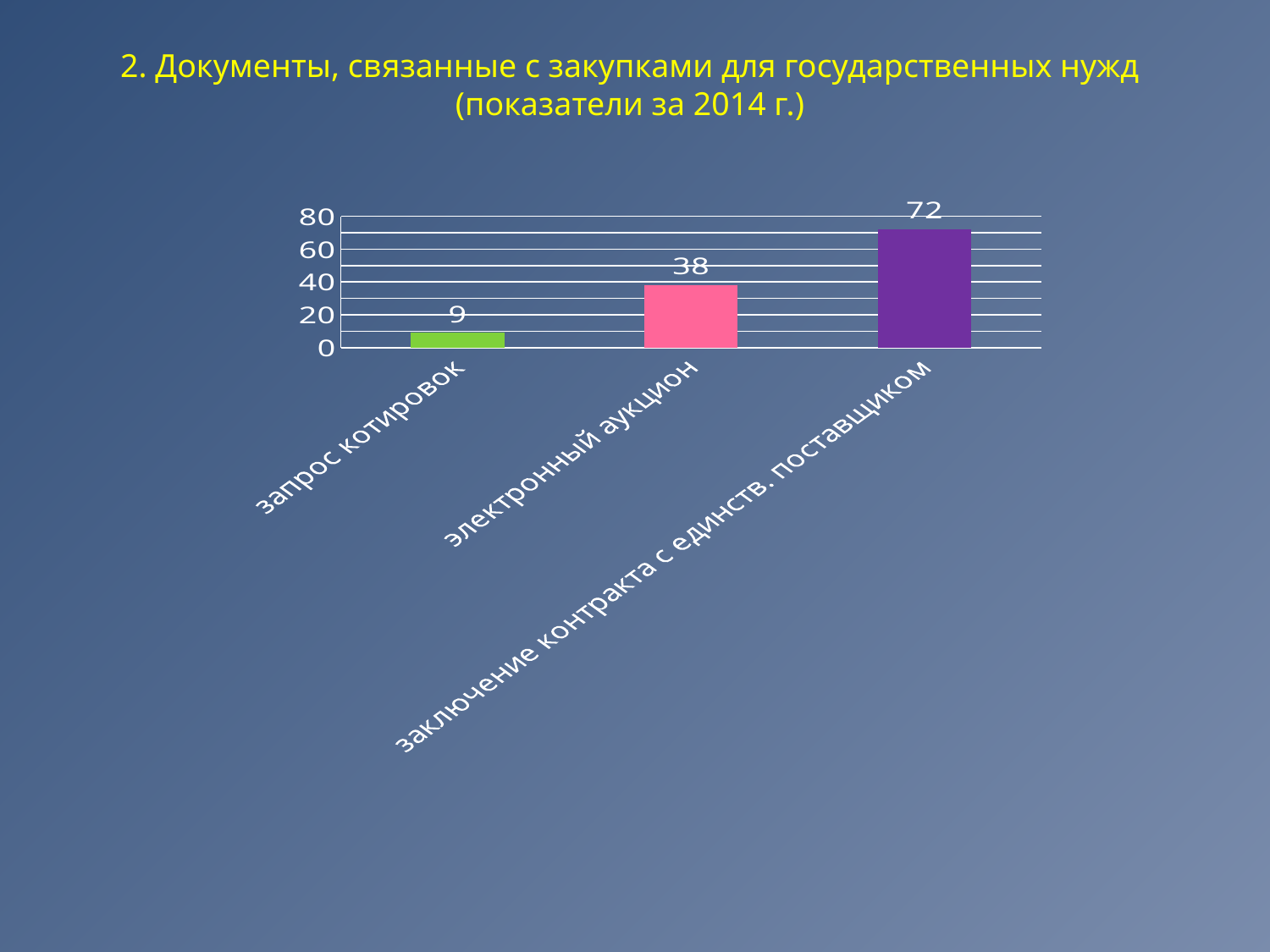
Which is larger, the value for электронный аукцион or the value for запрос котировок? электронный аукцион What is the value for запрос котировок? 9 What is the difference between the values for заключение контракта с единств. поставщиком and электронный аукцион? 34 What is the value for заключение контракта с единств. поставщиком? 72 How many categories are shown on the chart? 3 Which category has the lowest value? запрос котировок Is the value for электронный аукцион greater or less than 40? less Do the values rise or fall from left to right along the x axis? rise What is the value for электронный аукцион? 38 What kind of chart is shown on the slide? bar chart Which category has the highest value? заключение контракта с единств. поставщиком What is the difference between the values for электронный аукцион and запрос котировок? 29